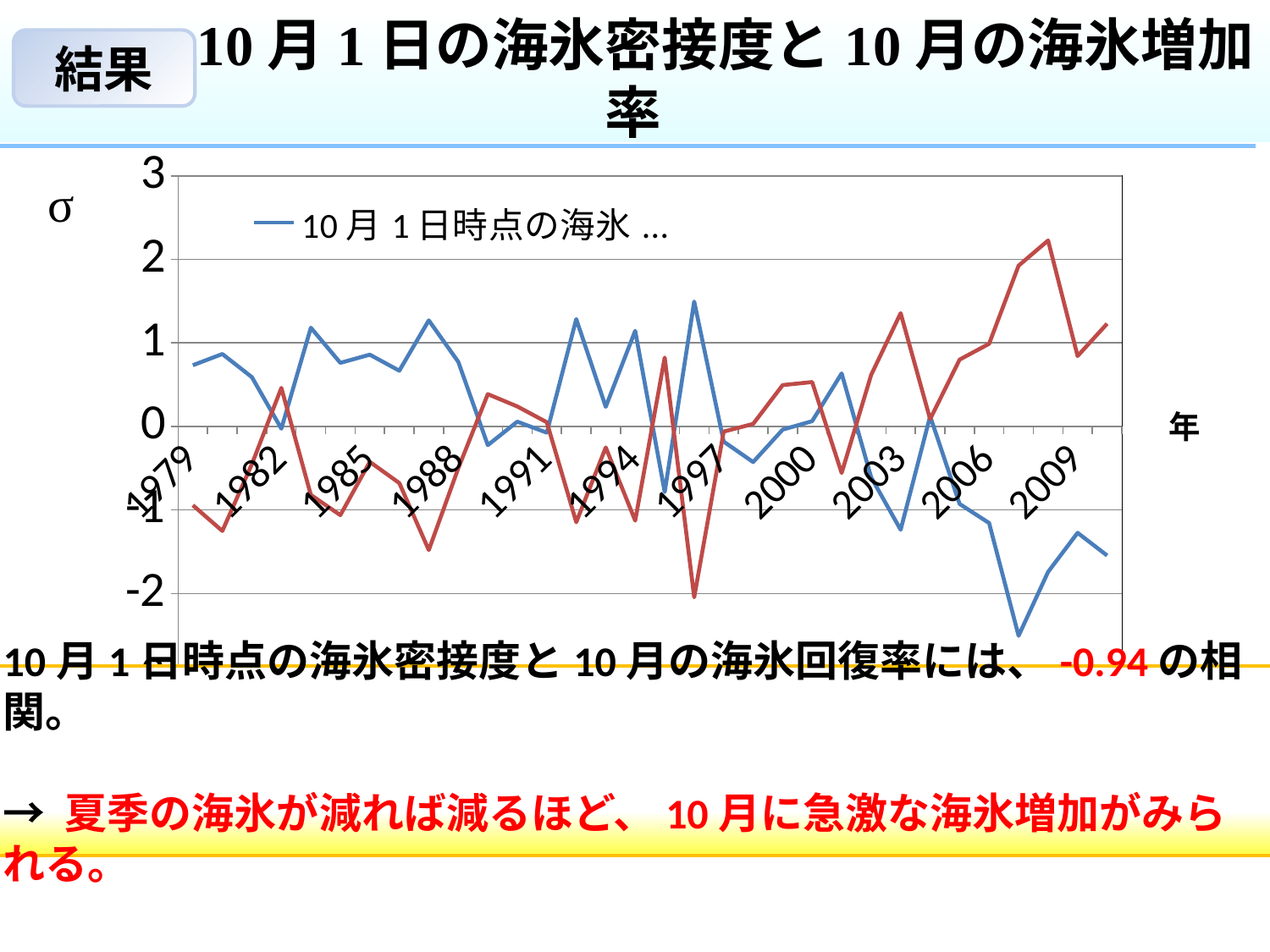
How many year labels are shown on the x axis? 11 In which year does the red line reach its highest value? 2008 Is the value of the blue line at 1996 greater or less than 1? greater How many series does the chart's legend list? 1 Is the value of the red line at 2009 greater or less than 2? less Is the value of the blue line at 2008 greater or less than -2? greater At 2009, which line has the higher value, the red line or the blue line? red line How many lines are plotted on the chart? 2 Overall, does the blue line rise or fall from 1979 to the end of the series? fall What kind of chart is shown on the slide? line chart In which year does the blue line reach its lowest value? 2007